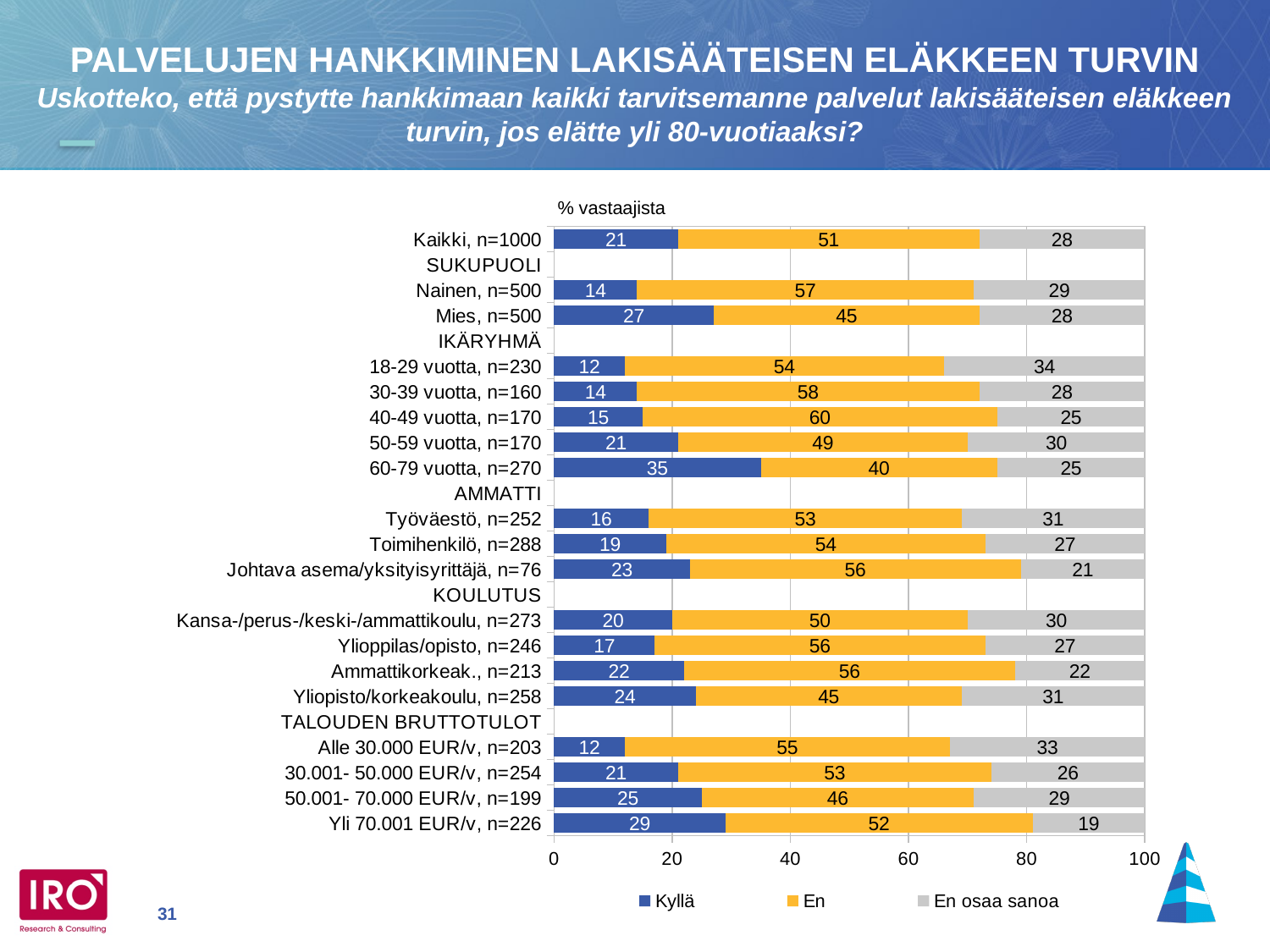
How many age groups (IKÄRYHMÄ) are shown in the chart? 5 What kind of chart is shown on the slide? Stacked bar chart What is the En value for the 40-49 vuotta, n=170 group? 60 How much higher is the Kyllä value for Mies, n=500 than for Nainen, n=500? 13 What is the total of the three segments for the Kaikki, n=1000 bar? 100 Which has a larger En value: Nainen, n=500 or Mies, n=500? Nainen, n=500 Which group has the highest En value? 40-49 vuotta, n=170 How many series does the legend list? 3 What is the En osaa sanoa value for Yli 70.001 EUR/v, n=226? 19 What percentage of all respondents (Kaikki, n=1000) answered Kyllä? 21 Which group has the lowest En osaa sanoa value? Yli 70.001 EUR/v, n=226 Which group has the highest Kyllä value? 60-79 vuotta, n=270